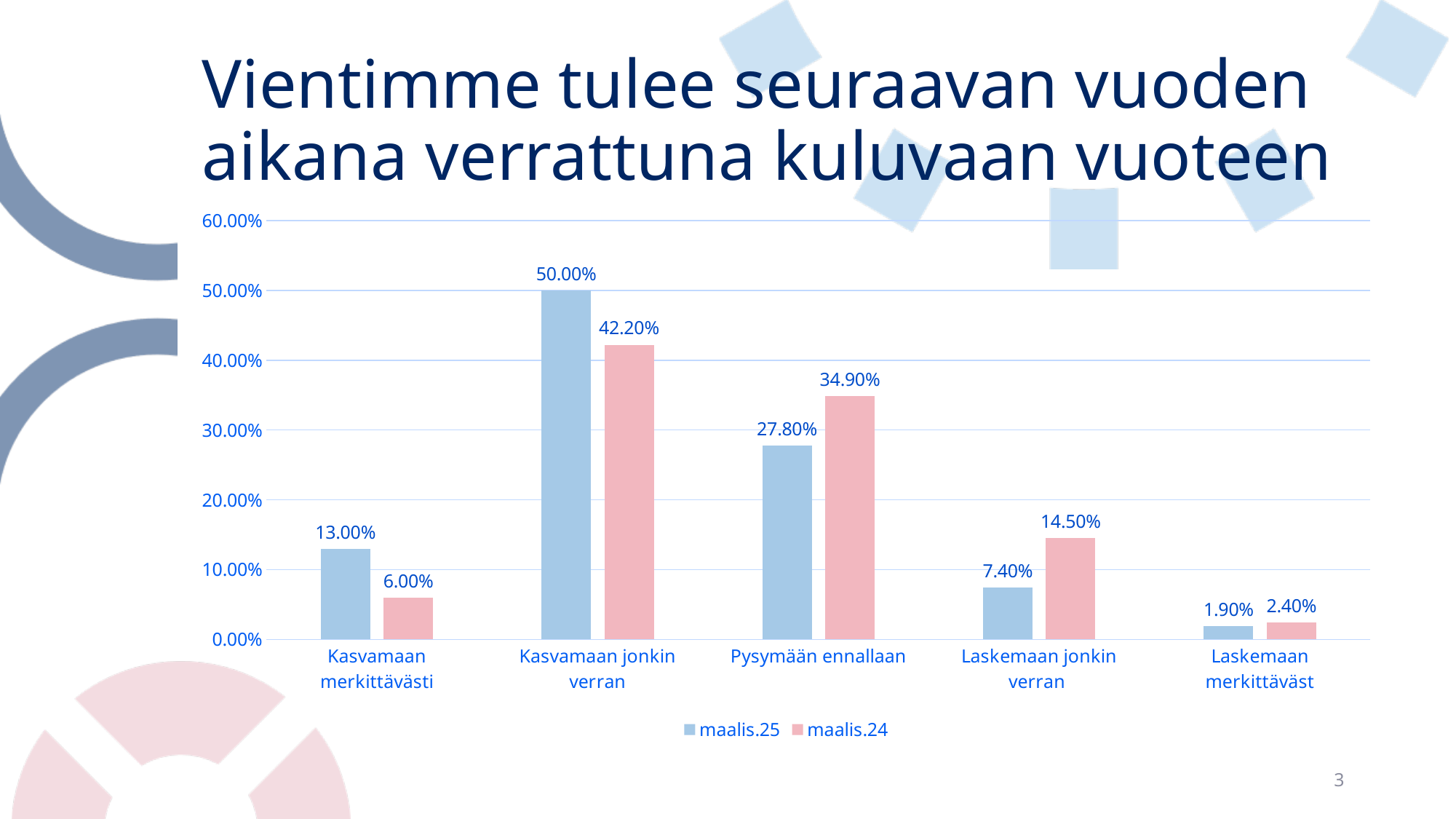
What are the two series names listed in the legend? maalis.25 and maalis.24 Which category has the highest value in the maalis.25 series? Kasvamaan jonkin verran What is the difference between the maalis.25 and maalis.24 values for "Kasvamaan jonkin verran"? 7.80% What kind of chart is shown on the slide? Bar chart What is the value for "Kasvamaan merkittävästi" in the maalis.24 series? 6.00% For "Pysymään ennallaan", which series has the larger value, maalis.25 or maalis.24? maalis.24 How many categories are shown on the x axis? 5 What is the value for "Kasvamaan jonkin verran" in the maalis.25 series? 50.00% What is the value for "Laskemaan jonkin verran" in the maalis.25 series? 7.40% Which category has the lowest value in the maalis.24 series? Laskemaan merkittäväst How many series does the legend list? 2 What is the value for "Pysymään ennallaan" in the maalis.24 series? 34.90%